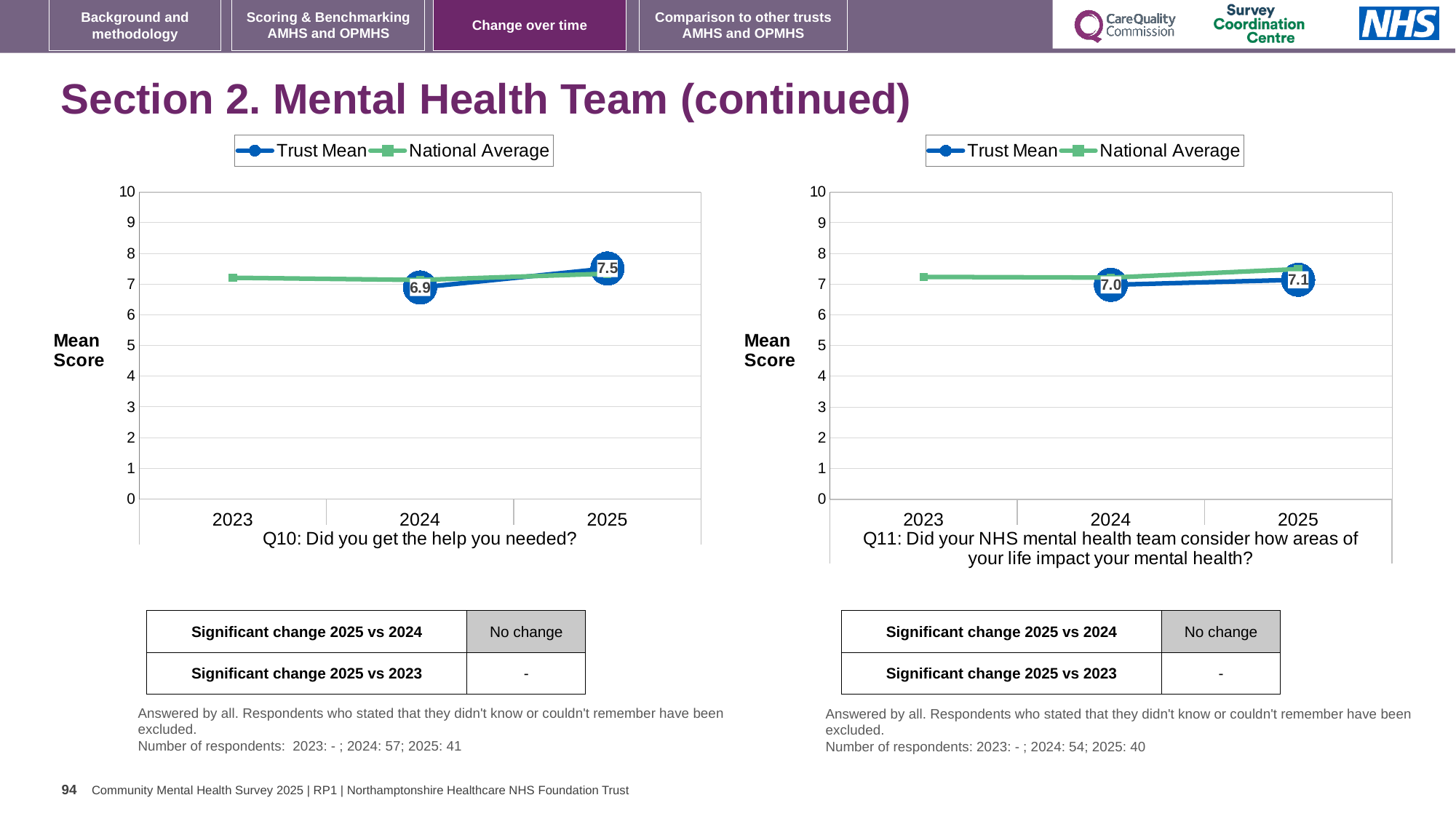
In the Q11 chart (right), what is the difference between the Trust Mean in 2025 and in 2024? 0.1 In the Q11 chart (right), what is the Trust Mean for 2024? 7.0 What type of chart is the Q11 chart (right)? line chart In the Q11 chart (right), what is the Trust Mean for 2025? 7.1 In the Q10 chart (left), what is the Trust Mean for 2024? 6.9 In the Q11 chart (right), is the National Average for 2023 greater or less than 5? greater How many years are shown on the x axis of the Q11 chart (right)? 3 In the Q10 chart (left), is the Trust Mean for 2025 greater or less than 7? greater In the Q10 chart (left), what is the Trust Mean for 2025? 7.5 How many series does the legend of the Q10 chart (left) list? 2 In the Q10 chart (left), by how much did the Trust Mean change from 2024 to 2025? 0.6 In the Q10 chart (left), does the Trust Mean rise or fall from 2024 to 2025? rise